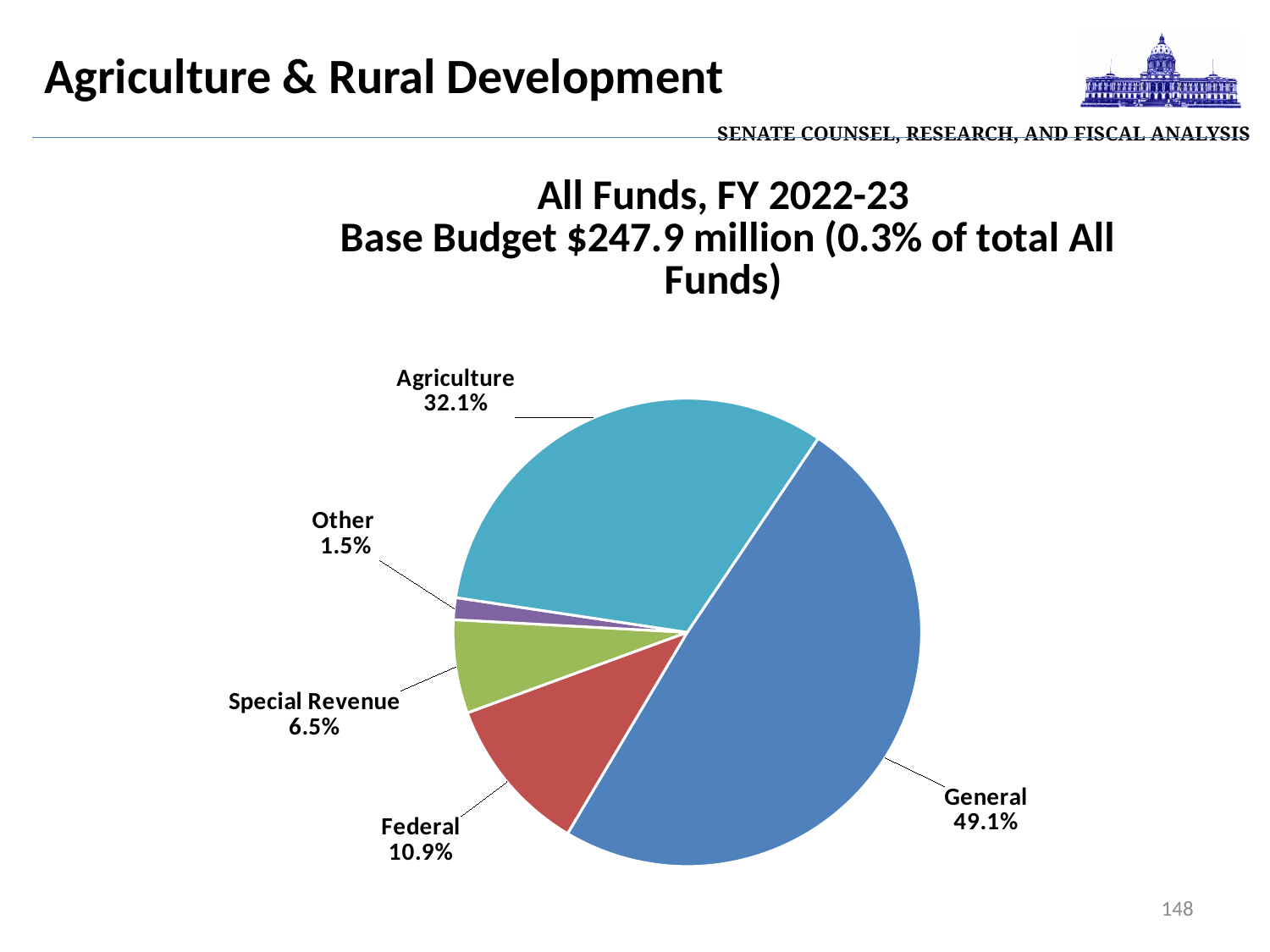
How many slices does the pie chart have? 5 What type of chart is shown on the slide? pie chart Which is larger, Federal or Special Revenue? Federal Which slice of the pie is the smallest? Other What is the title of the chart? All Funds, FY 2022-23 Base Budget $247.9 million (0.3% of total All Funds) What share of the pie does Agriculture represent? 32.1% Which slice of the pie is the largest? General What is the value shown for Other? 1.5% What share of the pie does General represent? 49.1% What is the value shown for Federal? 10.9% What is the difference in percentage points between General and Agriculture? 17.0% What is the value shown for Special Revenue? 6.5%